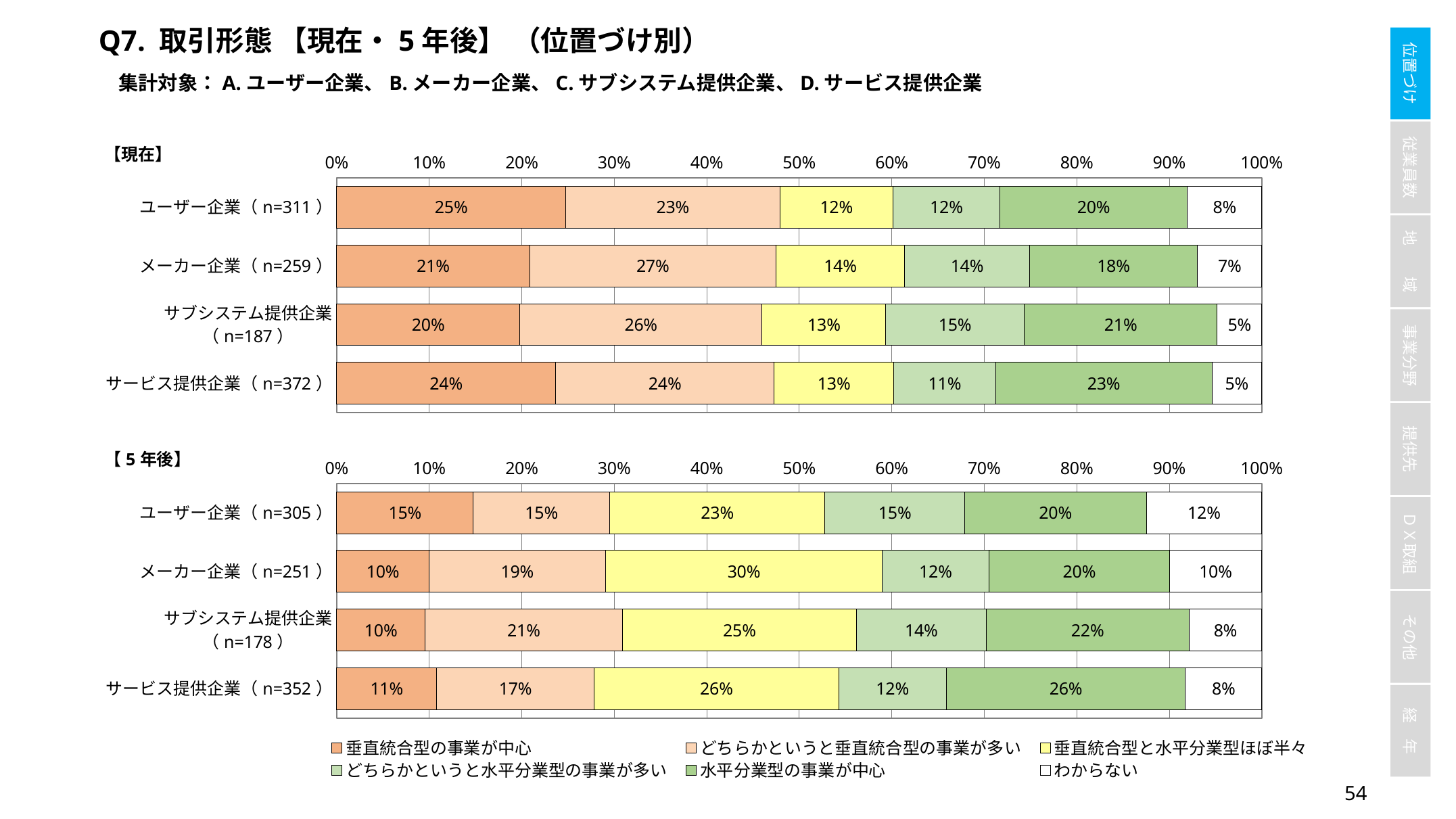
For ユーザー企業, how much lower is the 垂直統合型の事業が中心 value in the 【5年後】 chart than in the 【現在】 chart? 10 percentage points How many categories (company types) are shown in the 【現在】 chart? 4 In the 【現在】 chart, what is the value for 水平分業型の事業が中心 for サービス提供企業（n=372）? 23% In the 【5年後】 chart, which category has the highest value for 水平分業型の事業が中心? サービス提供企業（n=352） In the 【現在】 chart, which category has the highest value for わからない? ユーザー企業（n=311） In the 【現在】 chart, what is the difference between the どちらかというと垂直統合型の事業が多い values for メーカー企業 and ユーザー企業? 4 percentage points In the 【現在】 chart, what is the value for 垂直統合型の事業が中心 for ユーザー企業（n=311）? 25% In the 【5年後】 chart, which has the larger わからない value: ユーザー企業 or メーカー企業? ユーザー企業 How many series does the legend list? 6 In the 【5年後】 chart, which category has the lowest value for わからない? サブシステム提供企業（n=178）and サービス提供企業（n=352）, both 8% In the 【5年後】 chart, what is the value for 垂直統合型と水平分業型ほぼ半々 for メーカー企業（n=251）? 30% What kind of chart is the 【5年後】 chart? Stacked bar chart